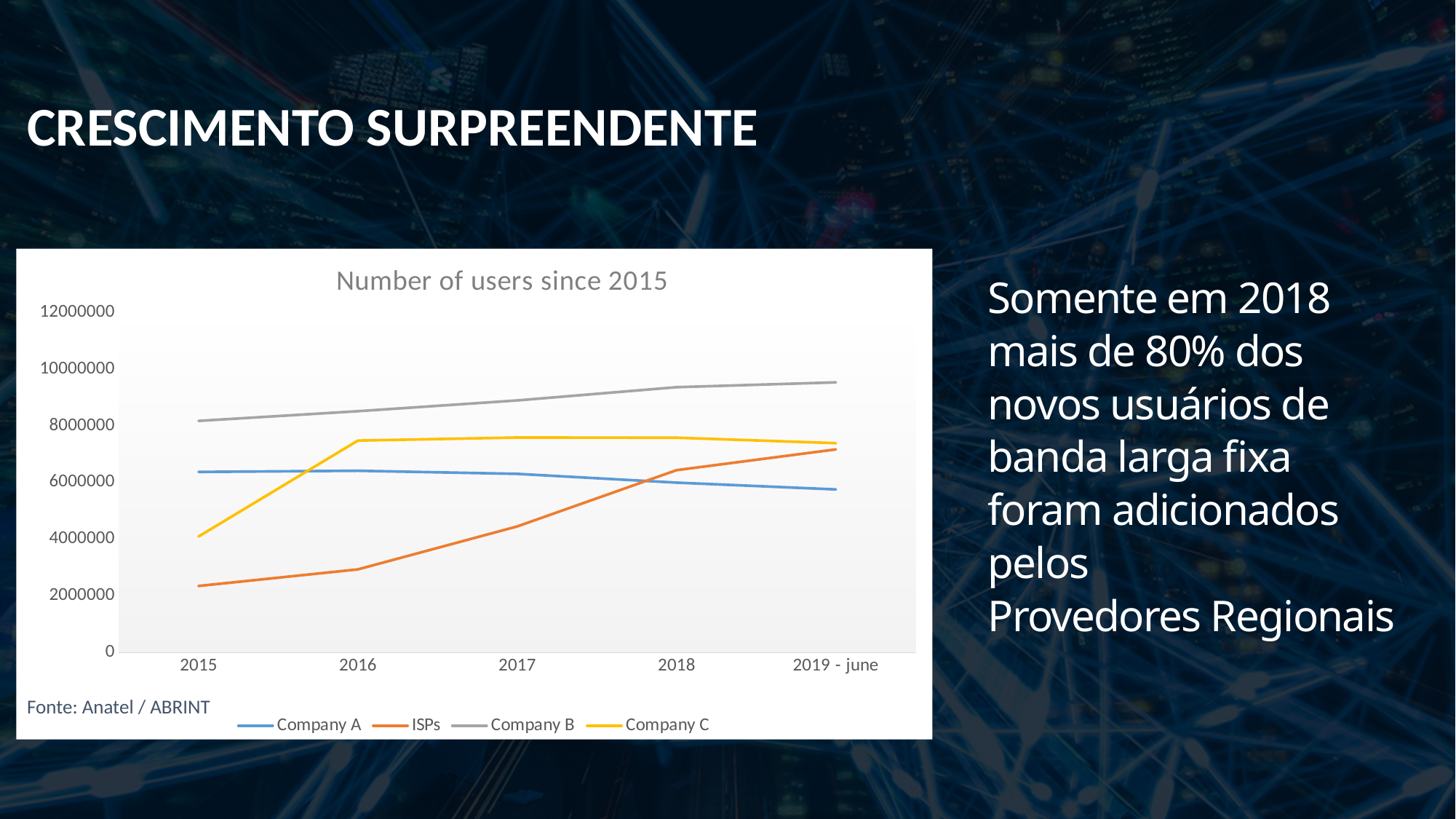
Which series has the highest number of users in 2015? Company B Do the values for ISPs rise or fall from 2015 to 2019 - june? rise What kind of chart is shown on the slide? line chart Do the values for Company A rise or fall from 2016 to 2019 - june? fall Which series has the lowest number of users in 2015? ISPs Which series is shown in orange in the chart? ISPs Is the value for ISPs in 2018 greater or less than 6000000? greater What is the title of the chart? Number of users since 2015 Which series has the lowest number of users in 2019 - june? Company A How many series does the legend of the chart list? 4 How many points are on the x axis of the chart? 5 In 2019 - june, which is larger: ISPs or Company A? ISPs